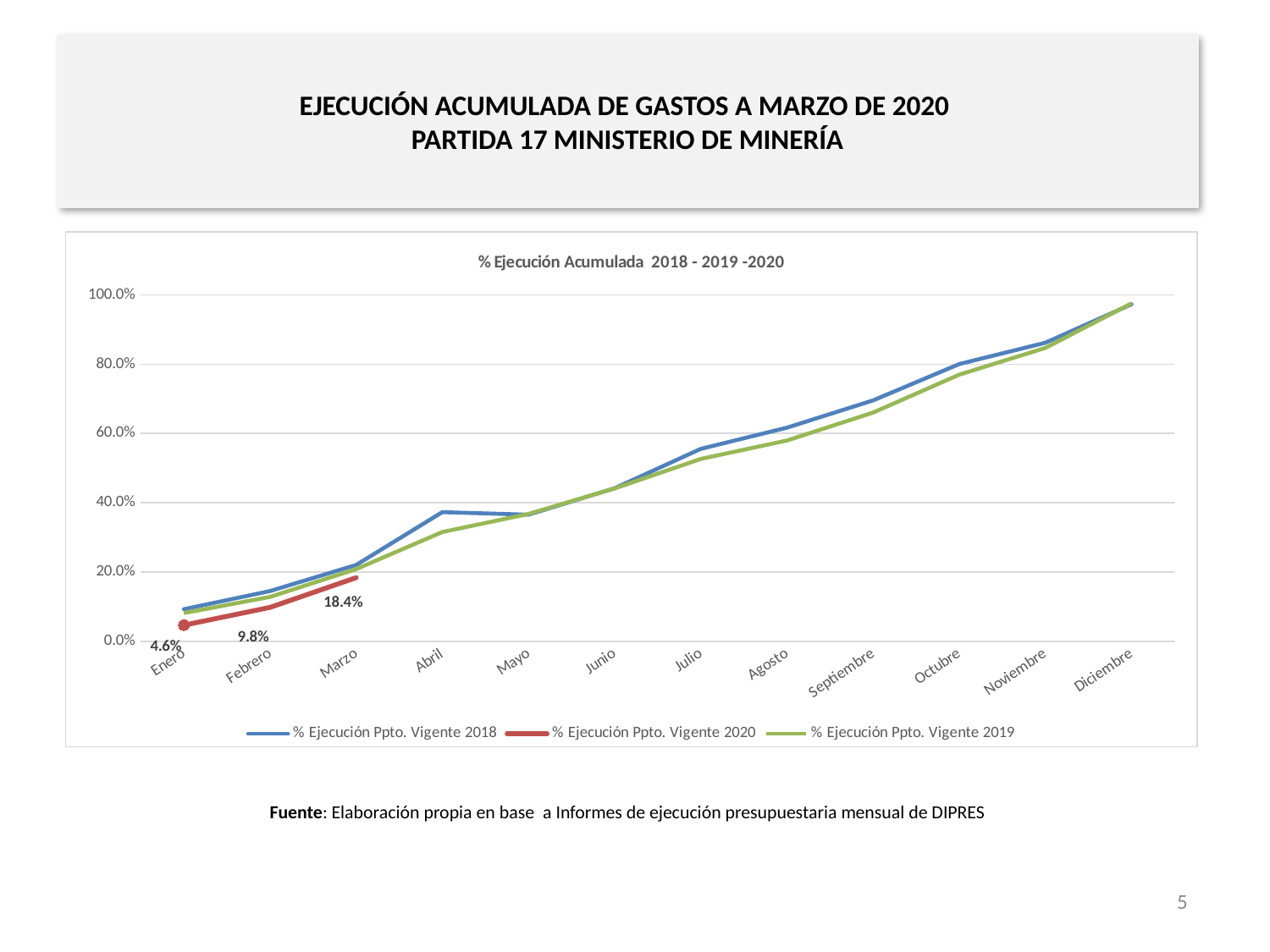
How many series does the legend list? 3 What kind of chart is shown on the slide? Line chart How many months are shown on the x axis? 12 In Abril, which series is higher: % Ejecución Ppto. Vigente 2018 or % Ejecución Ppto. Vigente 2019? % Ejecución Ppto. Vigente 2018 What is the value of % Ejecución Ppto. Vigente 2020 for Enero? 4.6% By how much did % Ejecución Ppto. Vigente 2020 increase from Febrero to Marzo? 8.6% Do the values for % Ejecución Ppto. Vigente 2018 rise or fall from Enero to Diciembre? Rise Is the value for % Ejecución Ppto. Vigente 2019 in Diciembre greater or less than 80%? greater What is the difference between the 2020 values for Febrero and Enero? 5.2% What is the value of % Ejecución Ppto. Vigente 2020 for Marzo? 18.4% What is the title of the chart? % Ejecución Acumulada 2018 - 2019 -2020 What is the value of % Ejecución Ppto. Vigente 2020 for Febrero? 9.8%